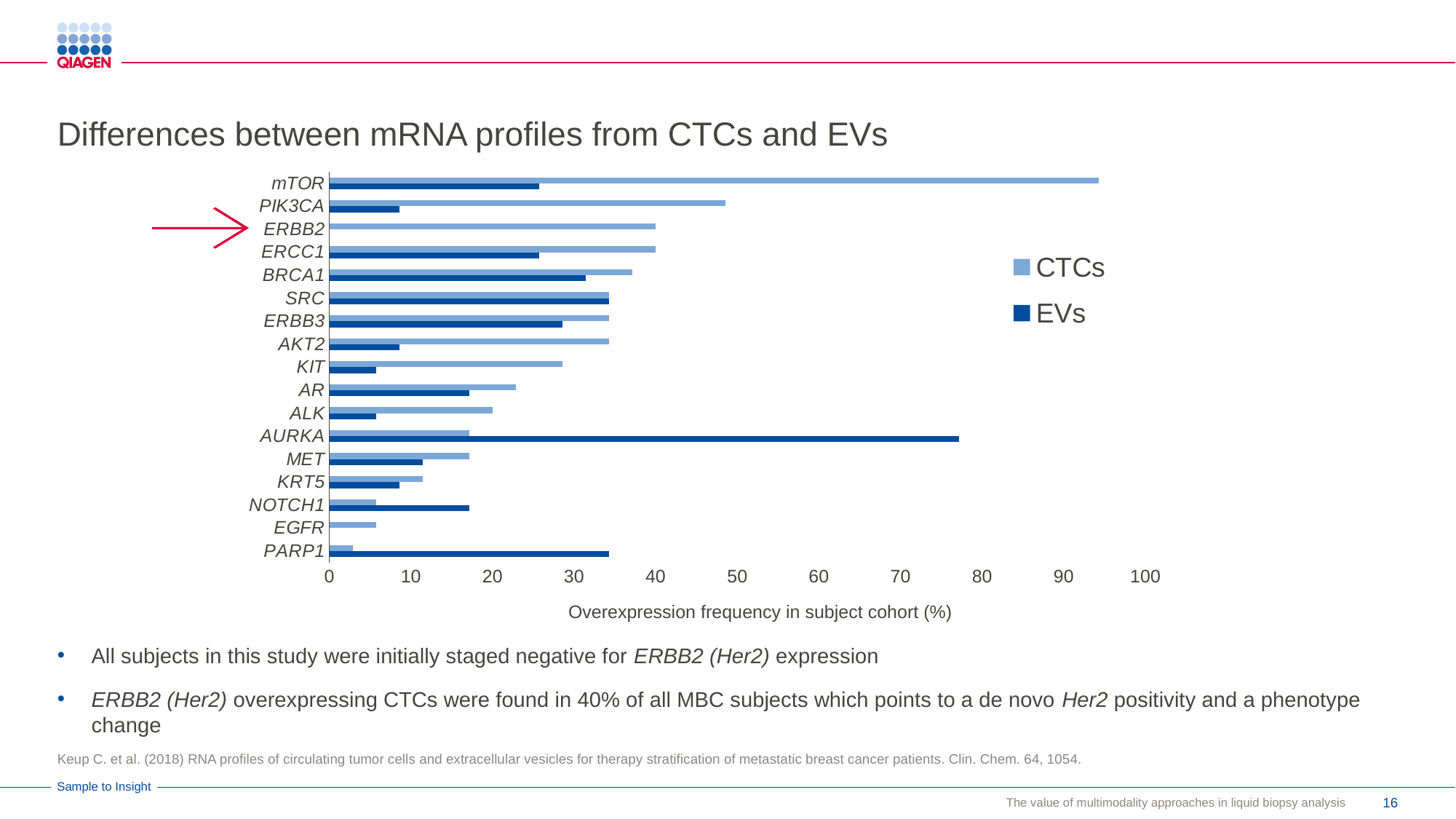
Which gene has the lowest CTCs overexpression frequency? PARP1 For PIK3CA, which series has the larger value, CTCs or EVs? CTCs For AURKA, which series has the larger value, CTCs or EVs? EVs How many series does the chart legend list? 2 Which gene has the highest CTCs overexpression frequency? mTOR Is the EVs value for AURKA greater or less than 70? greater Is the EVs value for KIT greater or less than 10? less Which gene has the highest EVs overexpression frequency? AURKA How many genes are listed on the vertical axis of the chart? 17 What is the title of the horizontal axis of the chart? Overexpression frequency in subject cohort (%) Is the CTCs value for mTOR greater or less than 90? greater What kind of chart is shown on the slide? Bar chart